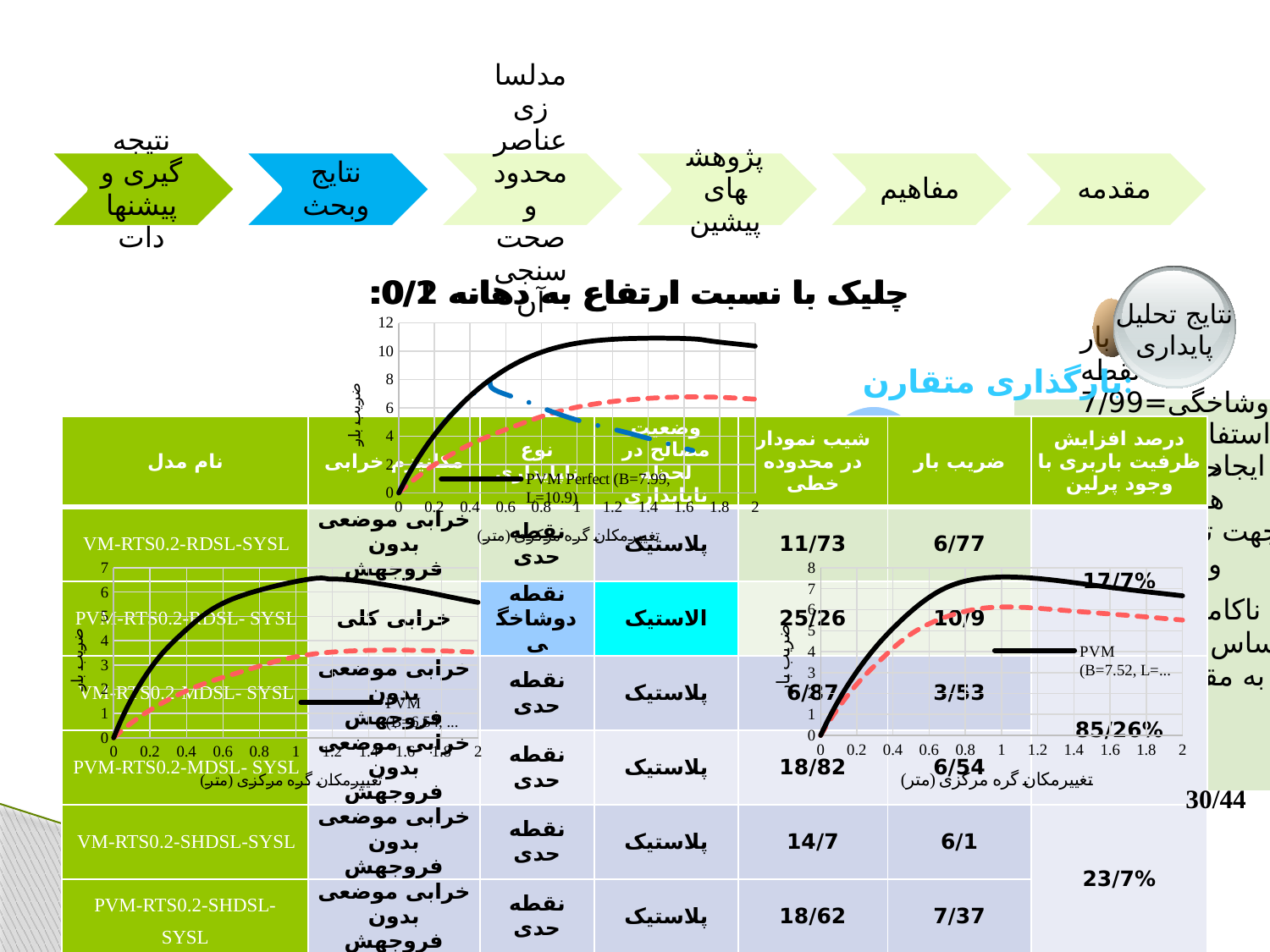
What kind of chart is the top-center chart with the y-axis running from 0 to 12? line chart In the top-center chart, which line reaches a higher peak, the solid black line or the red dashed line? the solid black line In the bottom-left chart with the y-axis running from 0 to 7, is the peak value of the solid black line greater or less than 5? greater In the top-center chart, does the solid black line rise or fall between x = 0 and x = 1? rise How many lines are plotted in the top-center chart? 3 In the bottom-left chart with the y-axis running from 0 to 7, is the peak value of the red dashed line greater or less than 5? less In the right-hand chart with the y-axis running from 0 to 8, which line reaches a higher peak, the solid black line or the red dashed line? the solid black line In the top-center chart, what is the highest value shown on the y-axis? 12 In the right-hand chart with the y-axis running from 0 to 8, is the peak value of the solid black line greater or less than 6? greater In the top-center chart, what is the highest value shown on the x-axis? 2